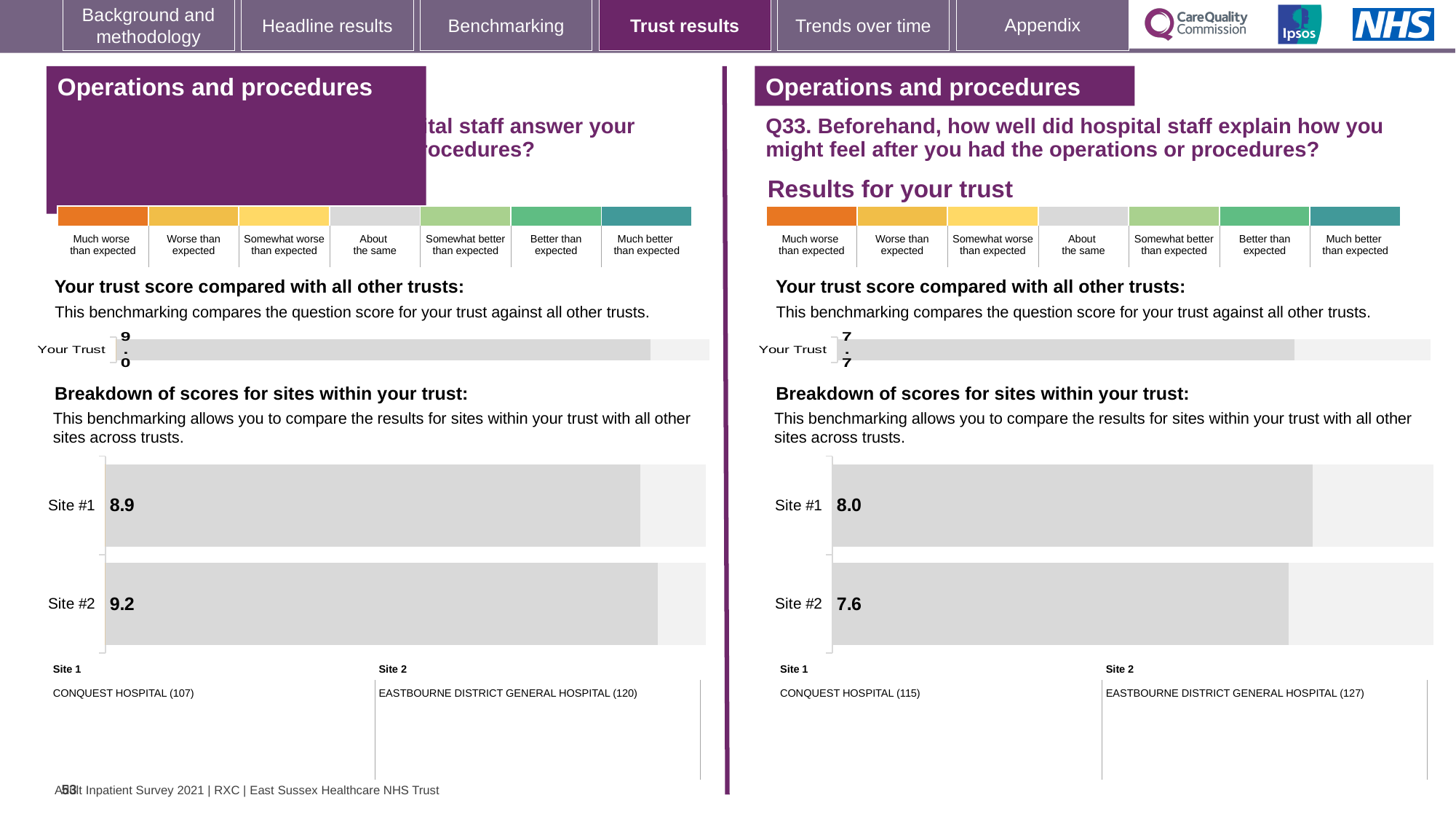
On the left-hand side of the slide, which site has the higher score in the breakdown of scores for sites within your trust? Site #2 On the left-hand side of the slide, what is the 'Your Trust' score in the trust score comparison chart? 9.0 In the Q33 site breakdown chart on the right-hand side of the slide, what is the difference between the Site #1 and Site #2 scores? 0.4 On the left-hand side of the slide, what is the score shown for Site #2 in the breakdown of scores for sites within your trust? 9.2 How many sites are shown in the Q33 site breakdown chart on the right-hand side of the slide? 2 On the left-hand side of the slide, what is the score shown for Site #1 in the breakdown of scores for sites within your trust? 8.9 On the left-hand side of the slide, what is the difference between the Site #2 and Site #1 scores in the site breakdown chart? 0.3 In the Q33 chart on the right-hand side of the slide, what is the score for Site #1? 8.0 In the Q33 chart on the right-hand side of the slide, what is the score for Site #2? 7.6 What type of chart is used for the breakdown of scores for sites within your trust on the left-hand side of the slide? Bar chart In the Q33 section on the right-hand side of the slide, what is the 'Your Trust' score? 7.7 In the Q33 site breakdown chart on the right-hand side of the slide, which site has the lower score? Site #2